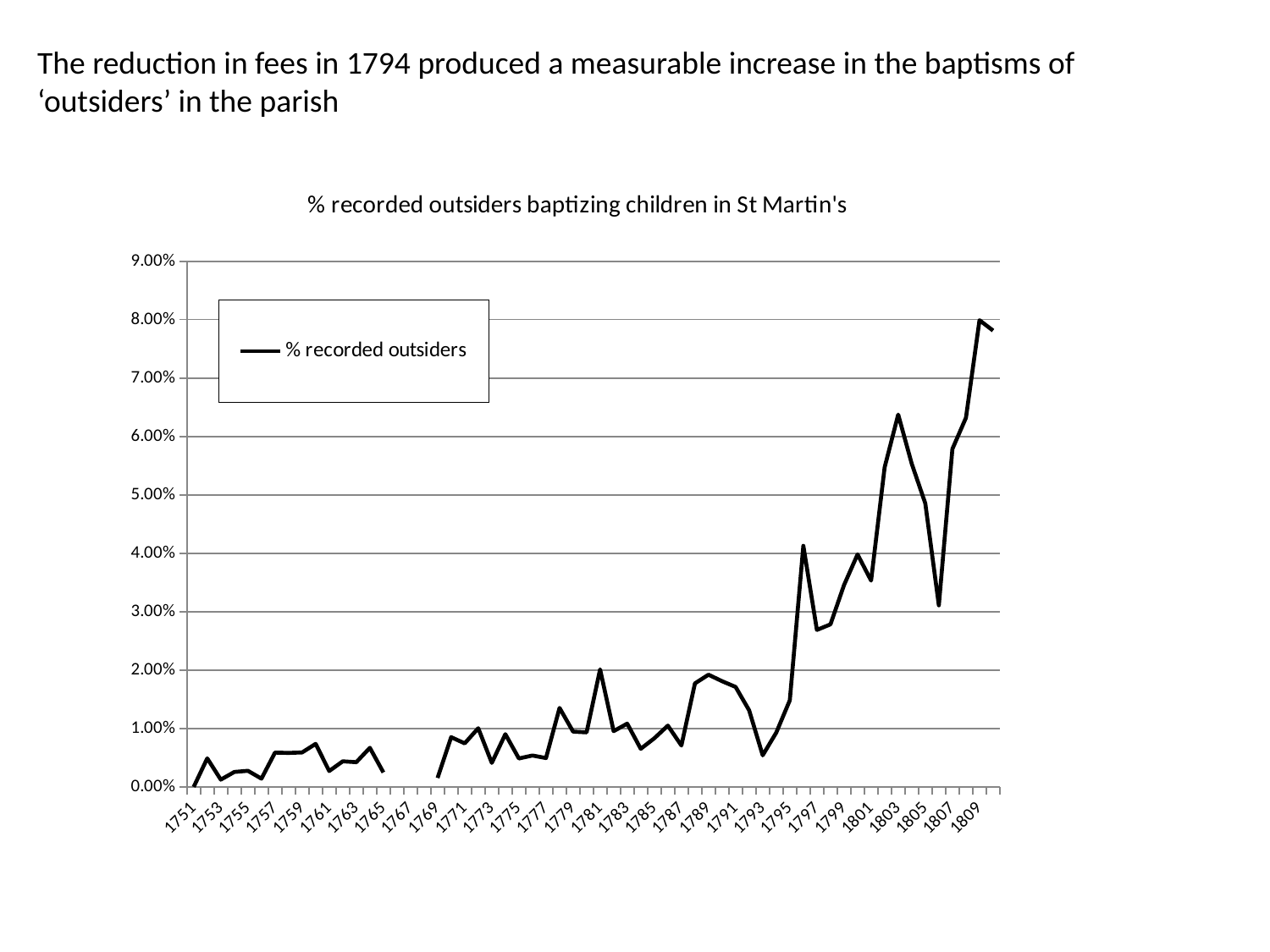
Is the value for 1809 greater or less than 7.00%? greater Which year has the larger value, 1803 or 1797? 1803 What is the title of the chart? % recorded outsiders baptizing children in St Martin's Is the value for 1793 greater or less than 1.00%? less What kind of chart is shown on the slide? line chart Is the value for 1803 greater or less than 6.00%? greater Which year has the highest value of % recorded outsiders? 1809 Overall, do the values rise or fall from 1751 to 1809? rise What is the name of the series shown in the legend? % recorded outsiders How many series does the legend list? 1